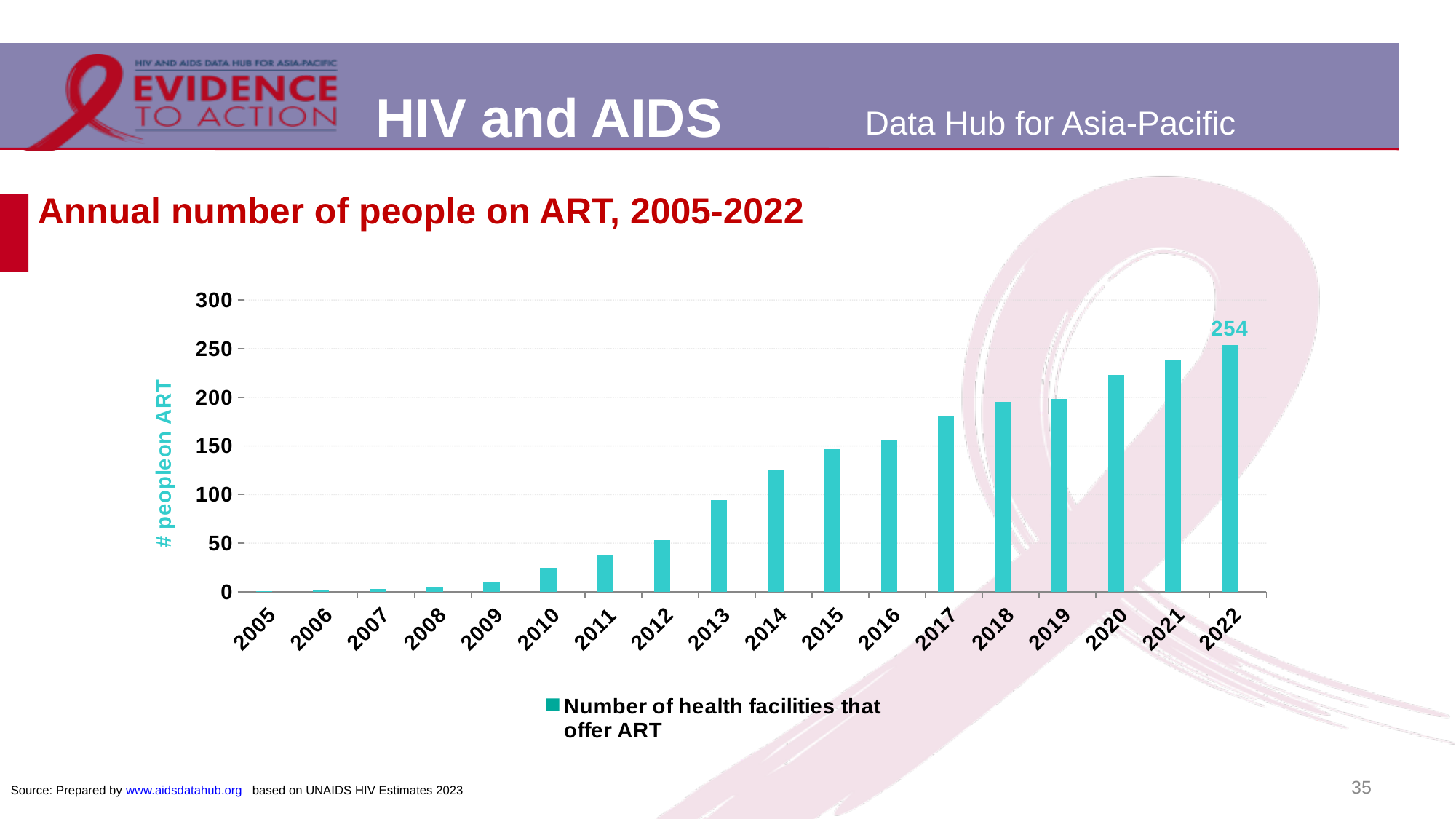
How many years are shown on the x axis? 18 Which year has the lowest value? 2005 What is the value for 2022? 254 Is the value for 2010 greater or less than 50? less What type of chart is shown on the slide? bar chart How many series does the legend list? 1 Is the value for 2017 greater or less than 150? greater Do the values rise or fall from 2005 to 2022? rise What is the legend entry for the series shown? Number of health facilities that offer ART Is the value for 2013 greater or less than 100? less Which year has the highest value? 2022 Which year has the larger value, 2015 or 2019? 2019